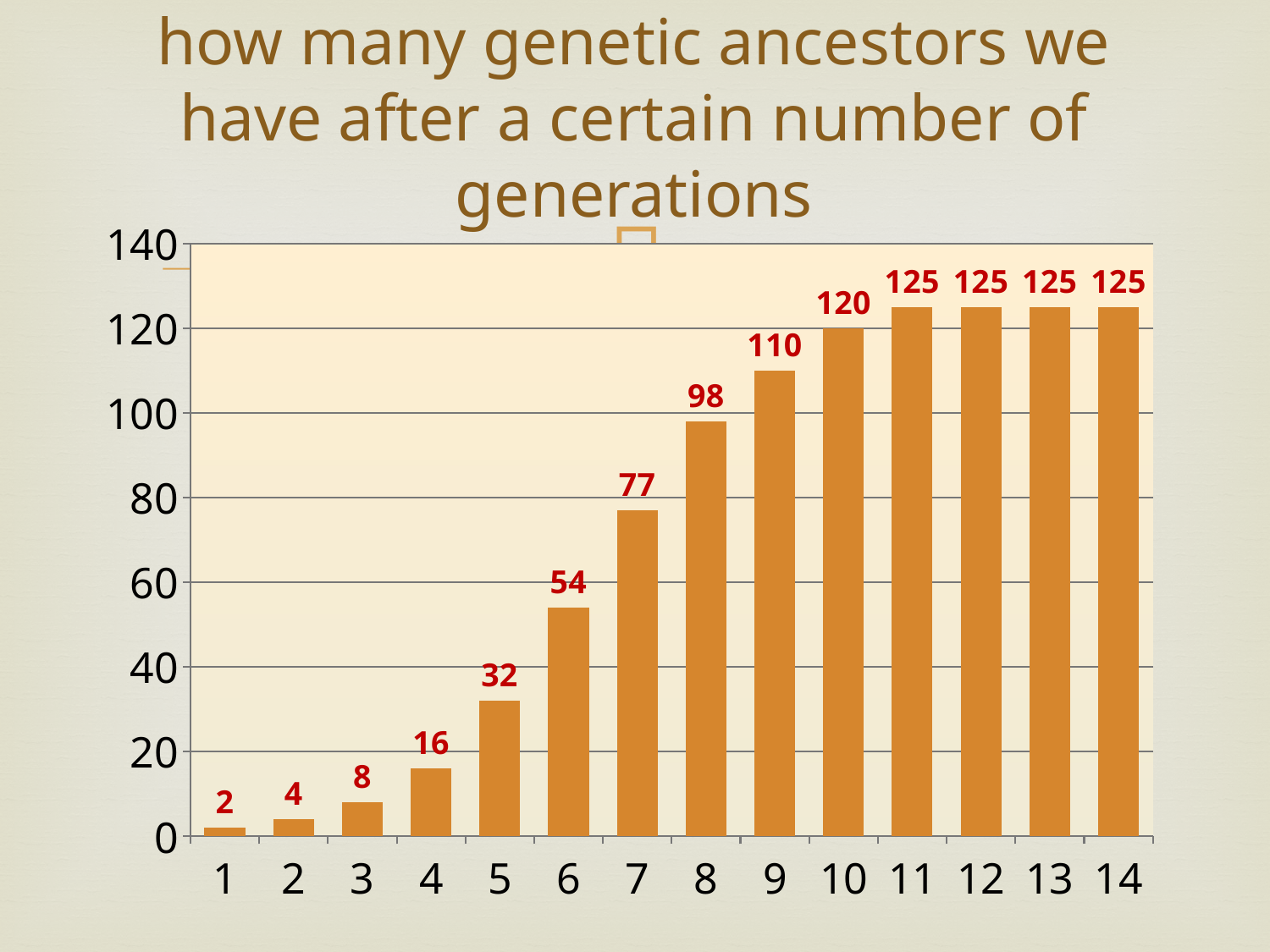
What is the value for generation 5? 32 Which is larger, the value for generation 3 or the value for generation 4? generation 4 What is the highest value shown on the chart? 125 What kind of chart is shown on the slide? bar chart What is the difference between the values for generation 6 and generation 4? 38 Is the value for generation 8 greater or less than 100? less Do the values rise or fall from generation 1 to generation 10? rise Which generation has the lowest value? 1 What is the value for generation 7? 77 What is the difference between the values for generation 9 and generation 8? 12 What is the value for generation 10? 120 How many generations (bars) are shown on the chart? 14